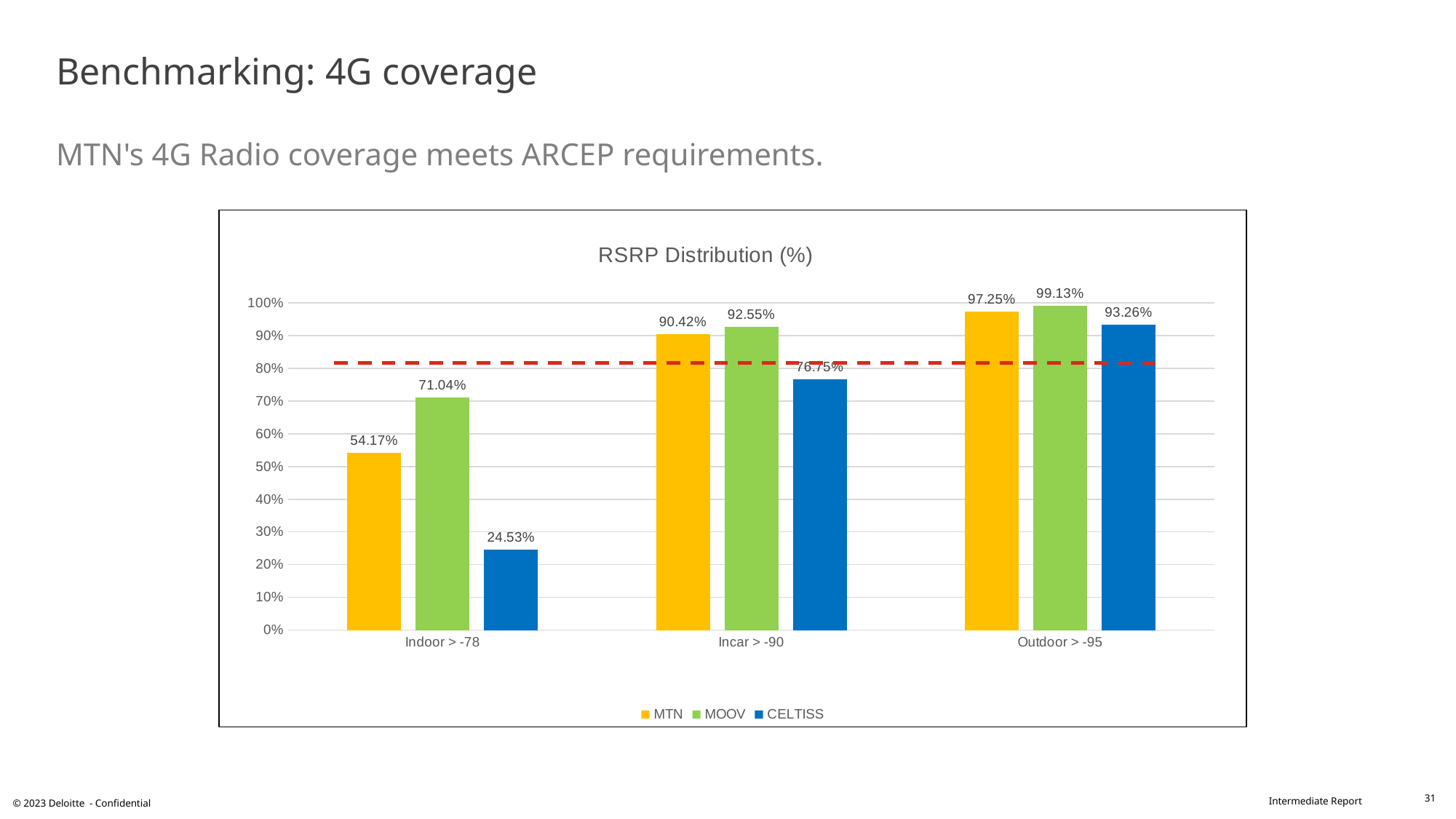
How many series does the legend list? 3 Which is larger in the Indoor > -78 category, MOOV or MTN? MOOV Which operator has the lowest value in the Indoor > -78 category? CELTISS Is the value for CELTISS in the Incar > -90 category greater or less than 80%? less How many categories are shown on the x axis? 3 What is the value for CELTISS in the Incar > -90 category? 76.75% What is the title of the chart? RSRP Distribution (%) What is the value for MTN in the Indoor > -78 category? 54.17% Which operator has the highest value in the Outdoor > -95 category? MOOV What is the value for MOOV in the Outdoor > -95 category? 99.13% What kind of chart is shown on the slide? bar chart What is the difference between MOOV and MTN in the Incar > -90 category? 2.13%